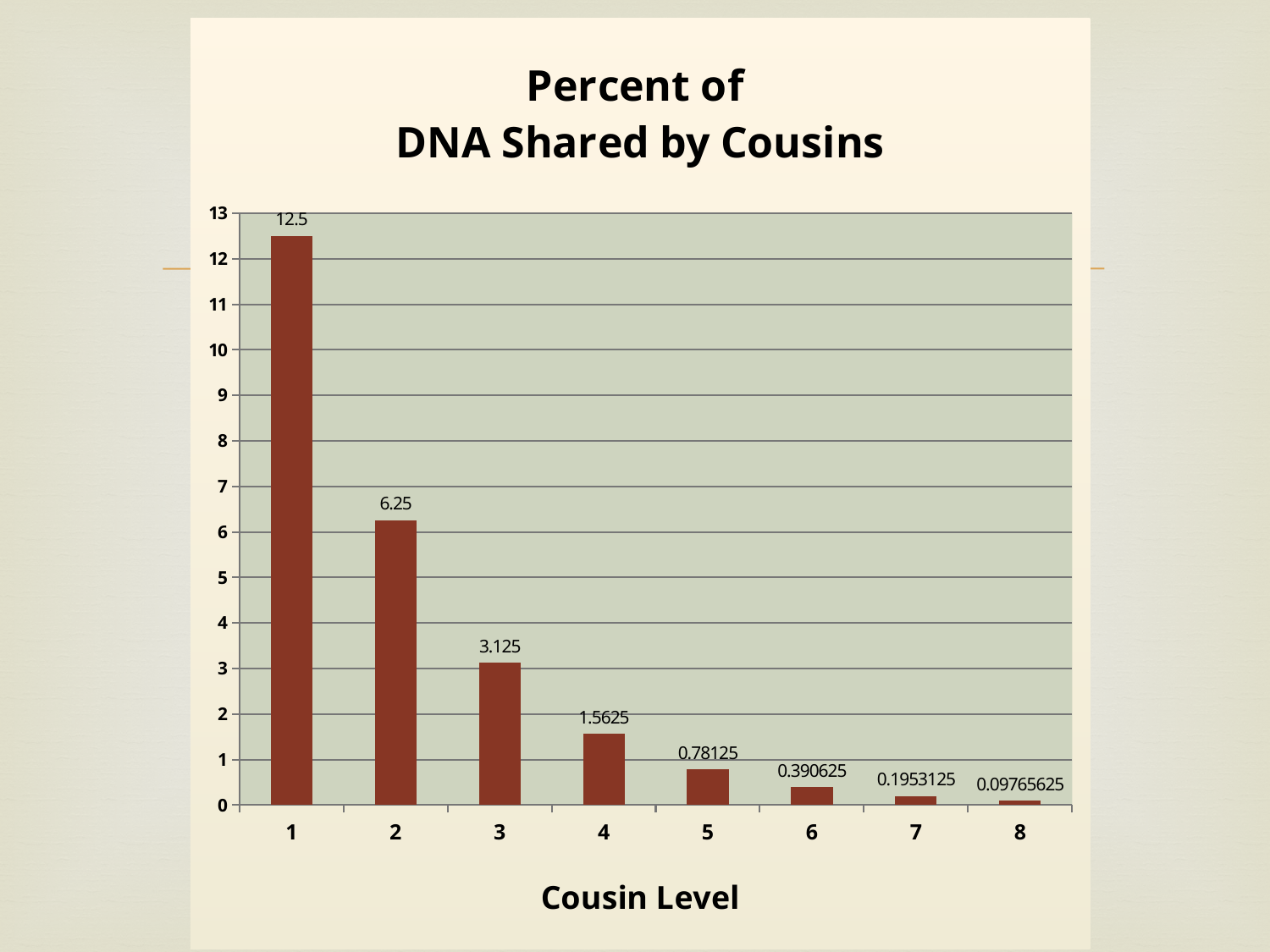
Do the values rise or fall as the cousin level increases from 1 to 8? Fall Which cousin level has the highest value? 1 What is the value for cousin level 8? 0.09765625 Which is larger, the value for cousin level 4 or cousin level 5? Cousin level 4 What is the value for cousin level 3? 3.125 What is the value for cousin level 1? 12.5 What is the title of the chart? Percent of DNA Shared by Cousins What is the value for cousin level 6? 0.390625 How many cousin levels are shown on the x axis? 8 Which cousin level has the lowest value? 8 What is the difference between the values for cousin level 1 and cousin level 2? 6.25 What kind of chart is shown on the slide? Bar chart